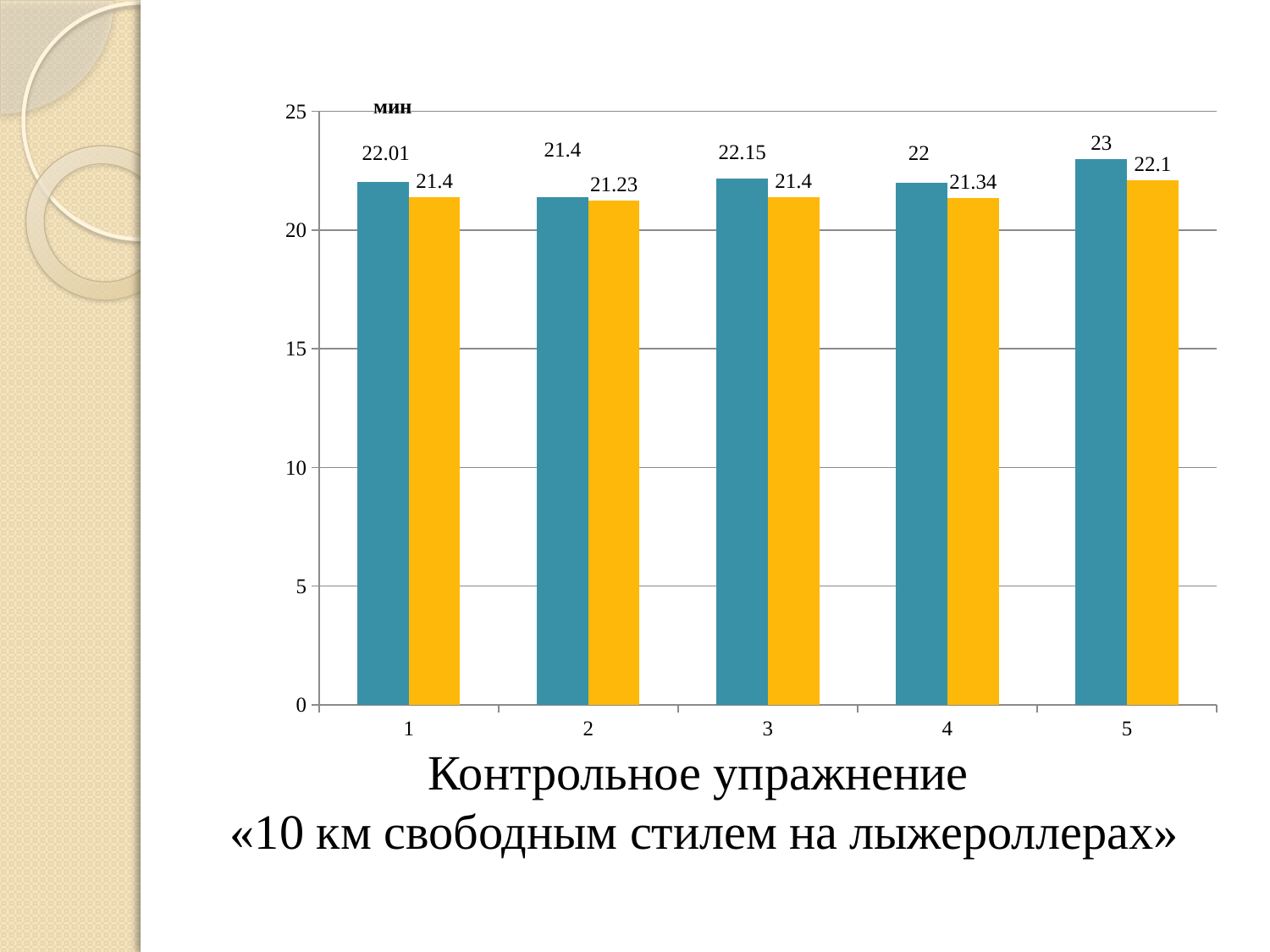
Is the value of the orange bar for category 3 greater or less than 20? greater For category 1, which bar is larger, the blue or the orange? blue How many categories are shown on the x axis? 5 What kind of chart is shown on the slide? bar chart What is the difference between the blue and orange bars for category 5? 0.9 Which category has the lowest orange bar? 2 What is the value of the blue bar for category 3? 22.15 What is the value of the orange bar for category 2? 21.23 What is the value of the blue bar for category 5? 23 What is the difference between the blue and orange bars for category 4? 0.66 What is the value of the orange bar for category 4? 21.34 Which category has the highest blue bar? 5